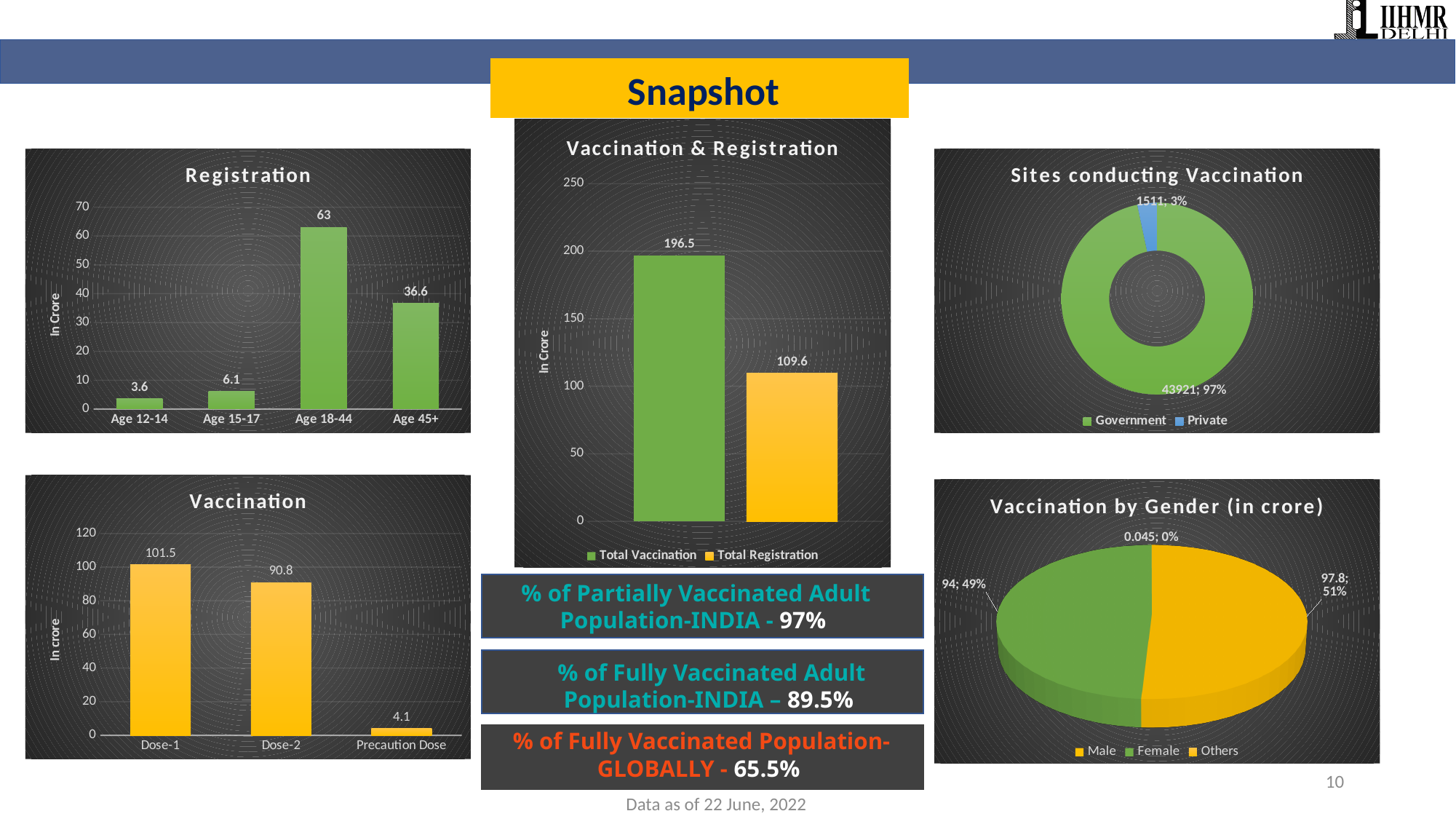
In the Vaccination chart, what is the value for Dose-2? 90.8 In the Registration chart, which age group has the lowest registration? Age 12-14 In the Vaccination chart, what is the difference between Dose-1 and Dose-2? 10.7 In the Vaccination by Gender chart, what is the value for Female? 94 In the Registration chart, what is the value for Age 18-44? 63 What kind of chart is Vaccination by Gender (in crore)? pie chart In the Vaccination & Registration chart, which is larger, Total Vaccination or Total Registration? Total Vaccination In the Registration chart, what is the difference between Age 18-44 and Age 45+? 26.4 In the Vaccination chart, do the values rise or fall from Dose-1 to Precaution Dose? fall How many age categories are shown in the Registration chart? 4 In the Vaccination & Registration chart, what is the value for Total Vaccination? 196.5 In the Sites conducting Vaccination chart, what share of sites are Government? 97%